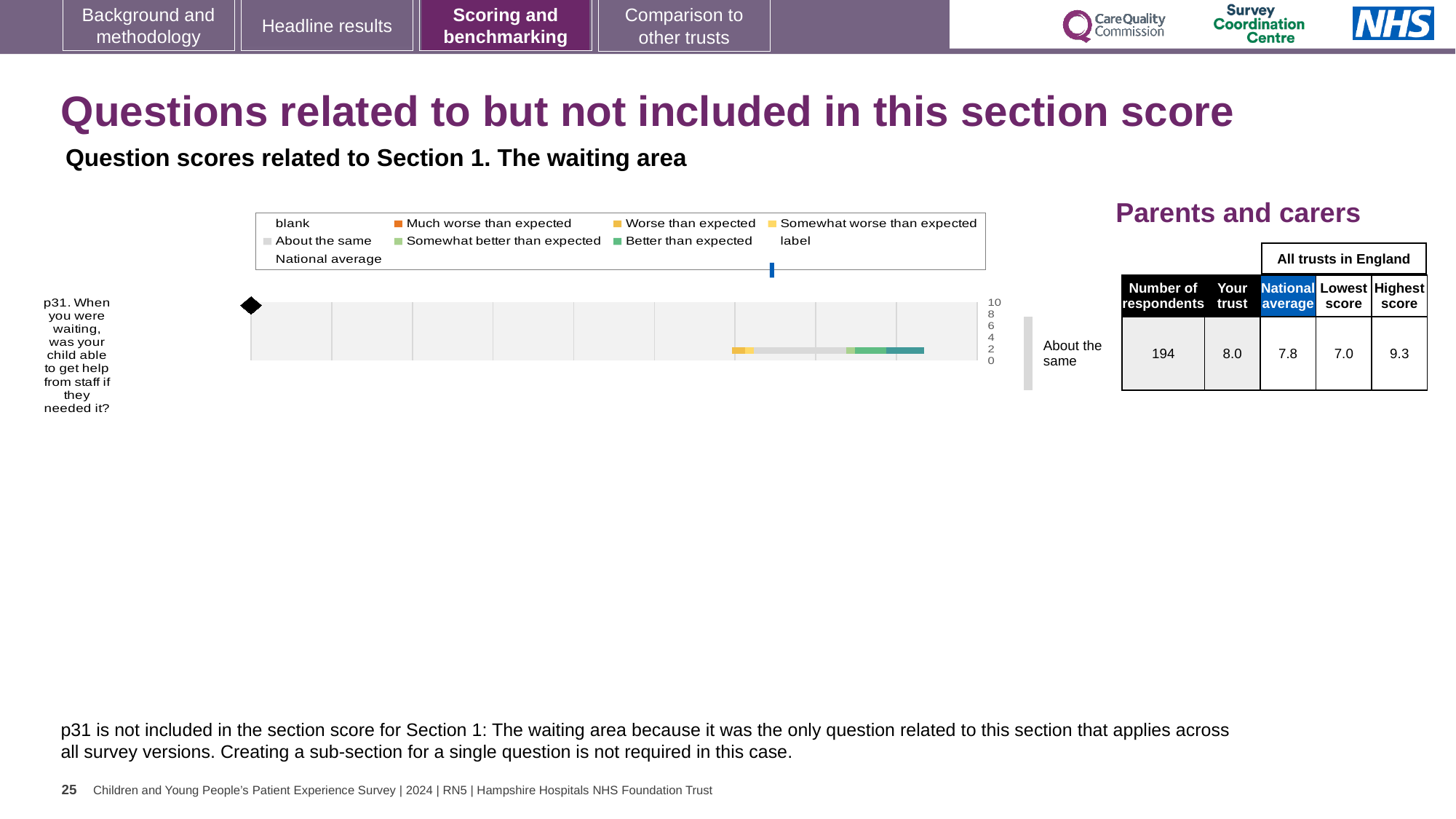
What benchmark category label is shown to the right of the bar for p31? About the same Which legend entry is shown in orange? Much worse than expected In the Parents and carers table, is the 'Your trust' score for p31 larger or smaller than the national average? larger In the Parents and carers table, what is the lowest score among all trusts in England for p31? 7.0 In the Parents and carers table, what is the national average score for p31? 7.8 Which question number is plotted in the chart? p31 In the Parents and carers table, what is the highest score among all trusts in England for p31? 9.3 In the Parents and carers table, what is the 'Your trust' score for p31? 8.0 How many survey questions are plotted in the chart? 1 What kind of chart is shown on the slide? bar chart In the Parents and carers table, what is the difference between the highest score and the lowest score for p31? 2.3 In the Parents and carers table, what is the number of respondents for p31? 194